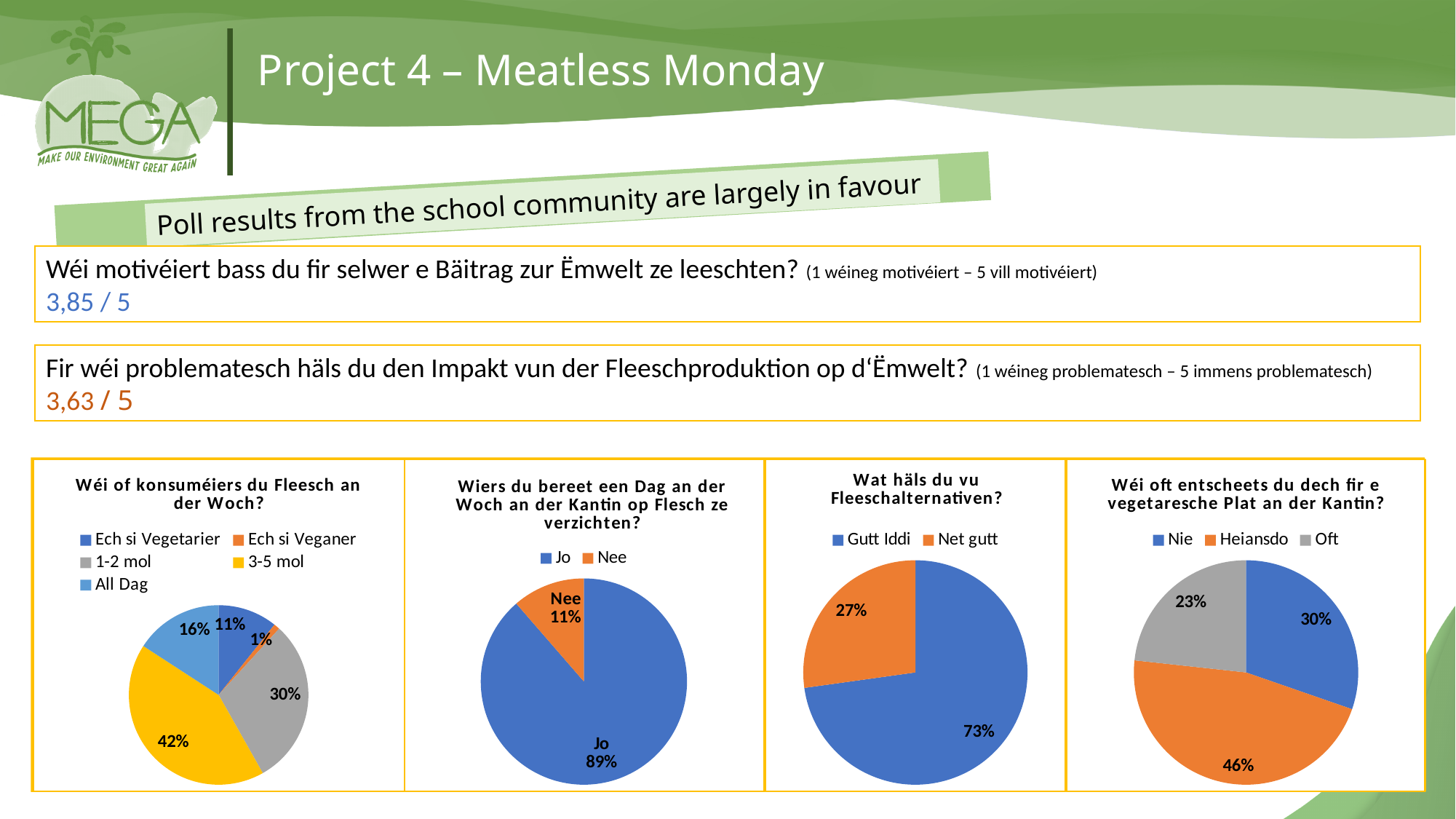
In the chart 'Wat häls du vu Fleeschalternativen?', which is larger, 'Gutt Iddi' or 'Net gutt'? Gutt Iddi In the chart 'Wiers du bereet een Dag an der Woch an der Kantin op Flesch ze verzichten?', what share answered 'Jo'? 89% In the chart 'Wat häls du vu Fleeschalternativen?', what share is labelled for 'Net gutt'? 27% In the chart 'Wéi oft entscheets du dech fir e vegetaresche Plat an der Kantin?', which category has the smallest share? Oft How many categories does the legend of the chart 'Wéi of konsuméiers du Fleesch an der Woch?' list? 5 In the chart 'Wéi of konsuméiers du Fleesch an der Woch?', what share is labelled for '3-5 mol'? 42% In the chart 'Wéi of konsuméiers du Fleesch an der Woch?', what is the difference between the '1-2 mol' and 'All Dag' shares? 14 percentage points In the chart 'Wéi of konsuméiers du Fleesch an der Woch?', which category has the largest slice? 3-5 mol In the chart 'Wéi of konsuméiers du Fleesch an der Woch?', which category has the smallest slice? Ech si Veganer In the chart 'Wéi oft entscheets du dech fir e vegetaresche Plat an der Kantin?', what share is labelled for 'Heiansdo'? 46% In the chart 'Wiers du bereet een Dag an der Woch an der Kantin op Flesch ze verzichten?', what share answered 'Nee'? 11% What type of chart is used for 'Wat häls du vu Fleeschalternativen?'? Pie chart